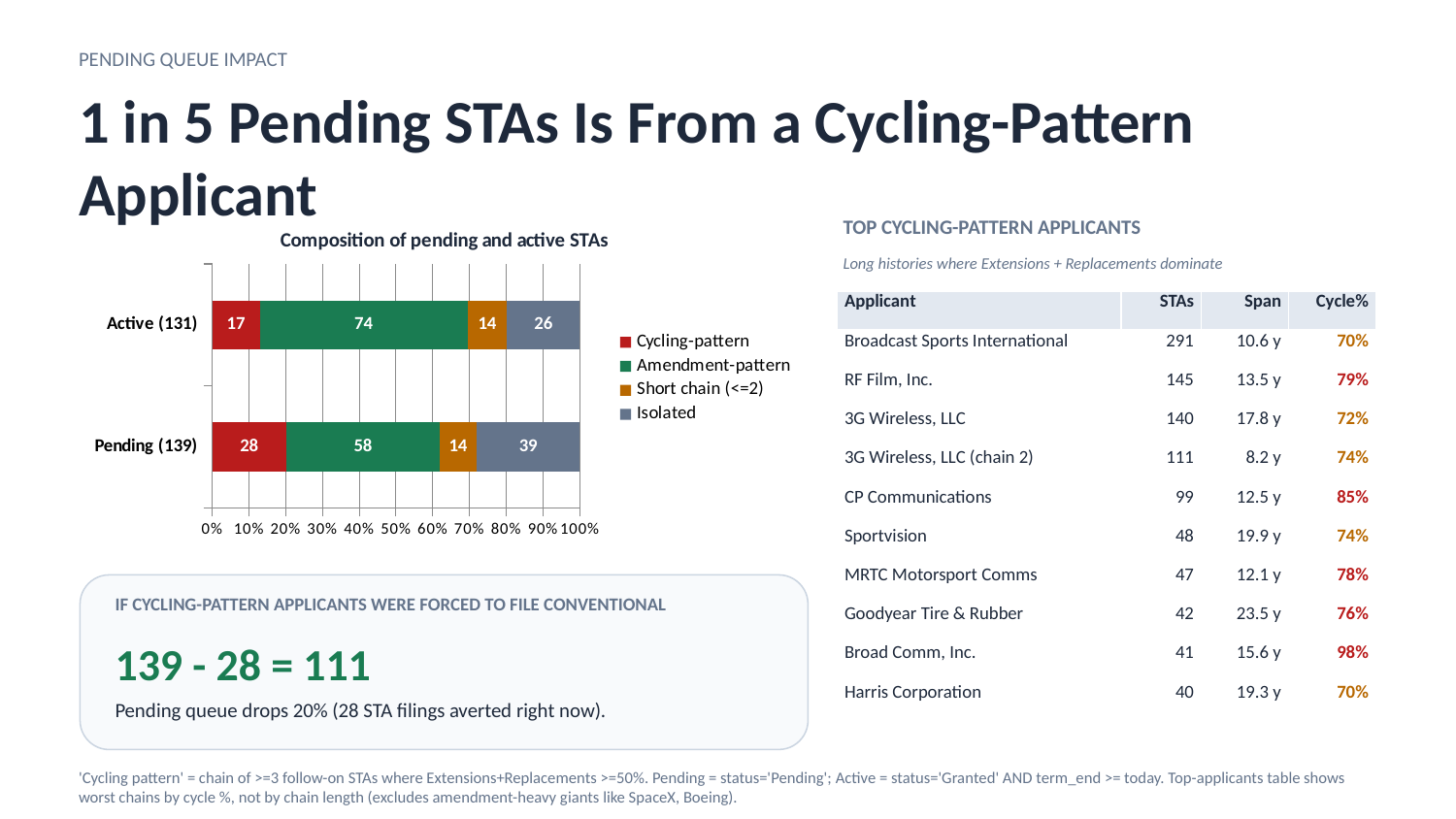
In the chart "Composition of pending and active STAs", which category has the larger Amendment-pattern value, Active (131) or Pending (139)? Active (131) In the chart "Composition of pending and active STAs", what is the Short chain (<=2) value for Active (131)? 14 What type of chart is "Composition of pending and active STAs"? Stacked bar chart How many series does the legend of "Composition of pending and active STAs" list? 4 In the chart "Composition of pending and active STAs", which series is shown in red? Cycling-pattern In the chart "Composition of pending and active STAs", what is the Amendment-pattern value for Active (131)? 74 In the chart "Composition of pending and active STAs", which series is the largest segment in the Active (131) bar? Amendment-pattern In the chart "Composition of pending and active STAs", what is the Cycling-pattern value for Pending (139)? 28 In the chart "Composition of pending and active STAs", what is the difference between the Cycling-pattern values for Pending (139) and Active (131)? 11 In the chart "Composition of pending and active STAs", what is the Isolated value for Pending (139)? 39 In the chart "Composition of pending and active STAs", what is the total of the stacked bar for Pending (139)? 139 How many categories (bars) are shown in the chart "Composition of pending and active STAs"? 2